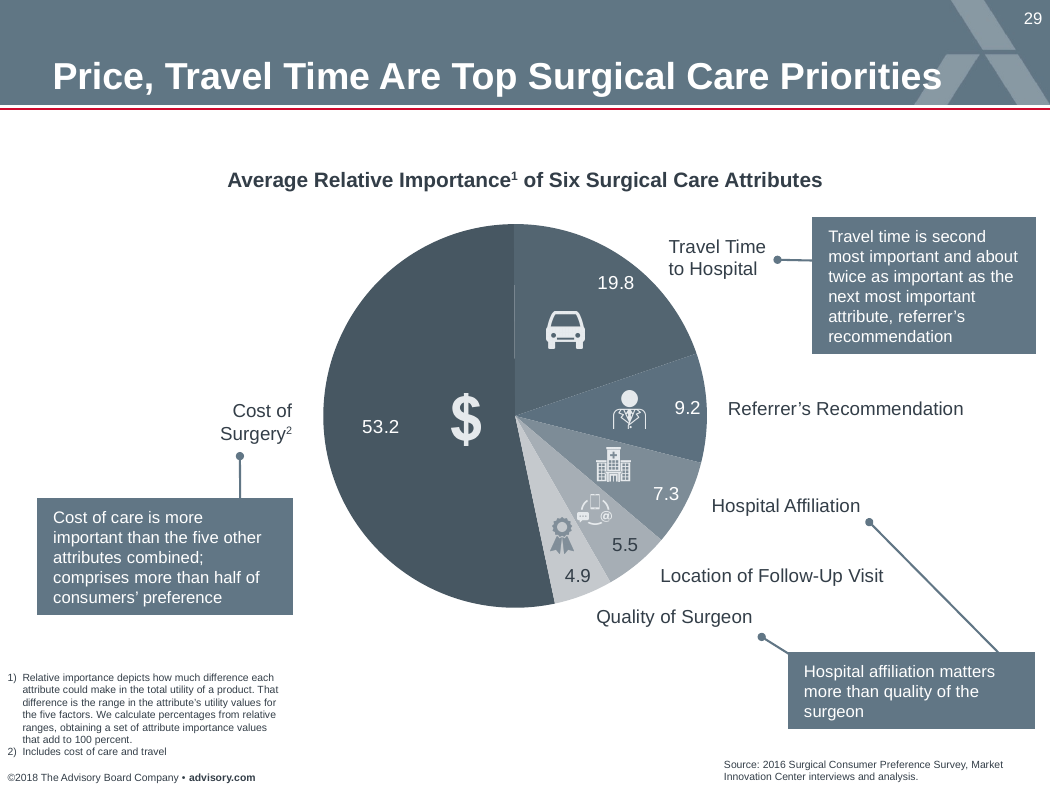
Which is larger, the value for Hospital Affiliation or the value for Location of Follow-Up Visit? Hospital Affiliation What is the value for Quality of Surgeon? 4.9 What is the title of the chart? Average Relative Importance of Six Surgical Care Attributes What is the value for Referrer's Recommendation? 9.2 What is the value for Hospital Affiliation? 7.3 What kind of chart is shown on the slide? Pie chart What is the difference between the values for Travel Time to Hospital and Referrer's Recommendation? 10.6 Which attribute has the largest slice of the pie? Cost of Surgery What is the value for Cost of Surgery? 53.2 How many attributes (slices) are shown in the pie chart? 6 What is the value for Travel Time to Hospital? 19.8 Which attribute has the smallest slice of the pie? Quality of Surgeon